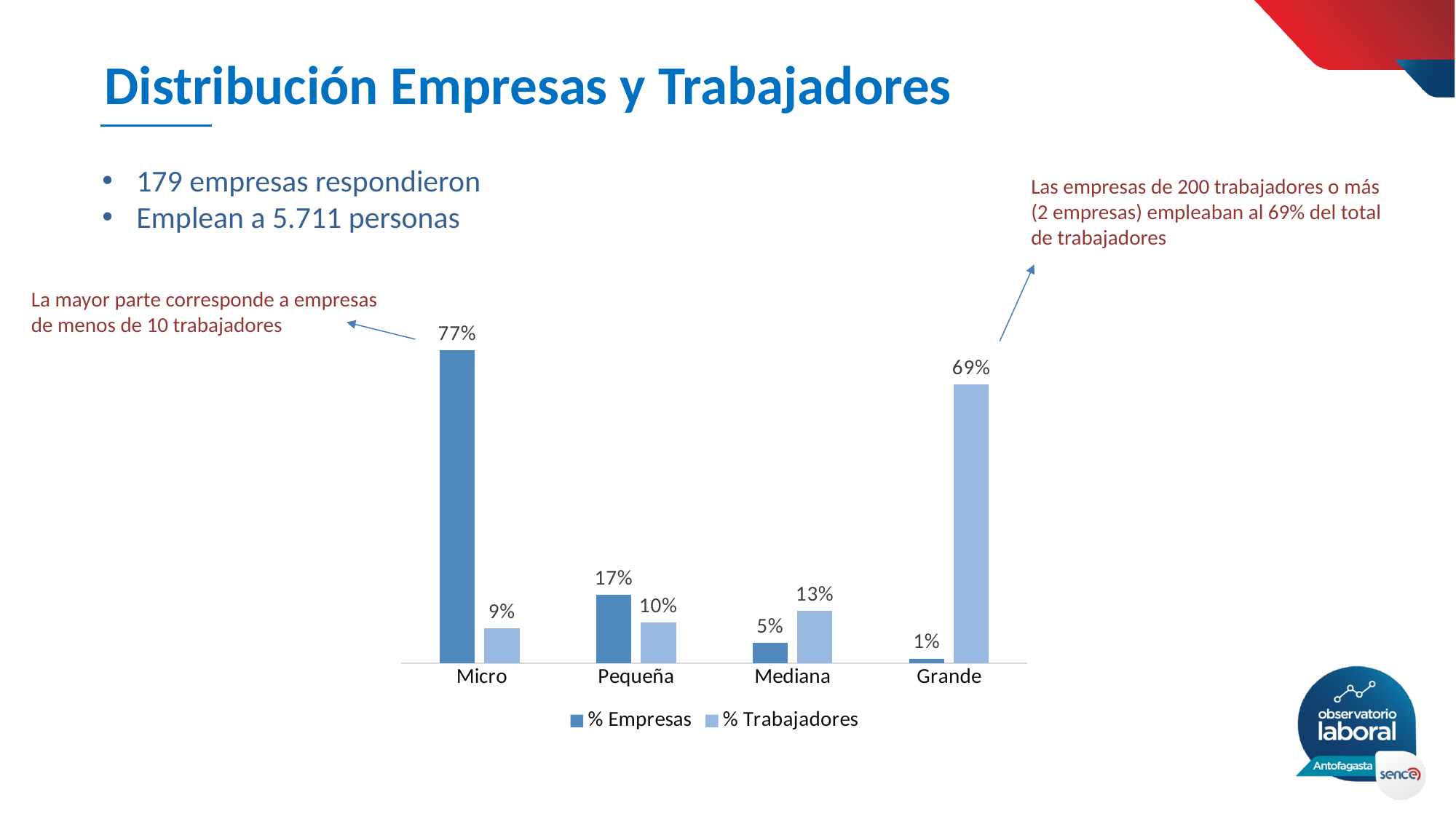
Do the % Empresas values rise or fall from Micro to Grande? Fall What is the % Trabajadores value for Grande? 69% Which category has the lowest % Trabajadores value? Micro Which is larger for Pequeña: % Empresas or % Trabajadores? % Empresas What is the % Trabajadores value for Mediana? 13% What is the % Empresas value for Pequeña? 17% What is the difference between the % Empresas and % Trabajadores values for Grande? 68% What kind of chart is shown on the slide? Bar chart What is the % Empresas value for Micro? 77% How many series does the legend list? 2 Which category has the highest % Empresas value? Micro How many categories are shown on the x axis? 4